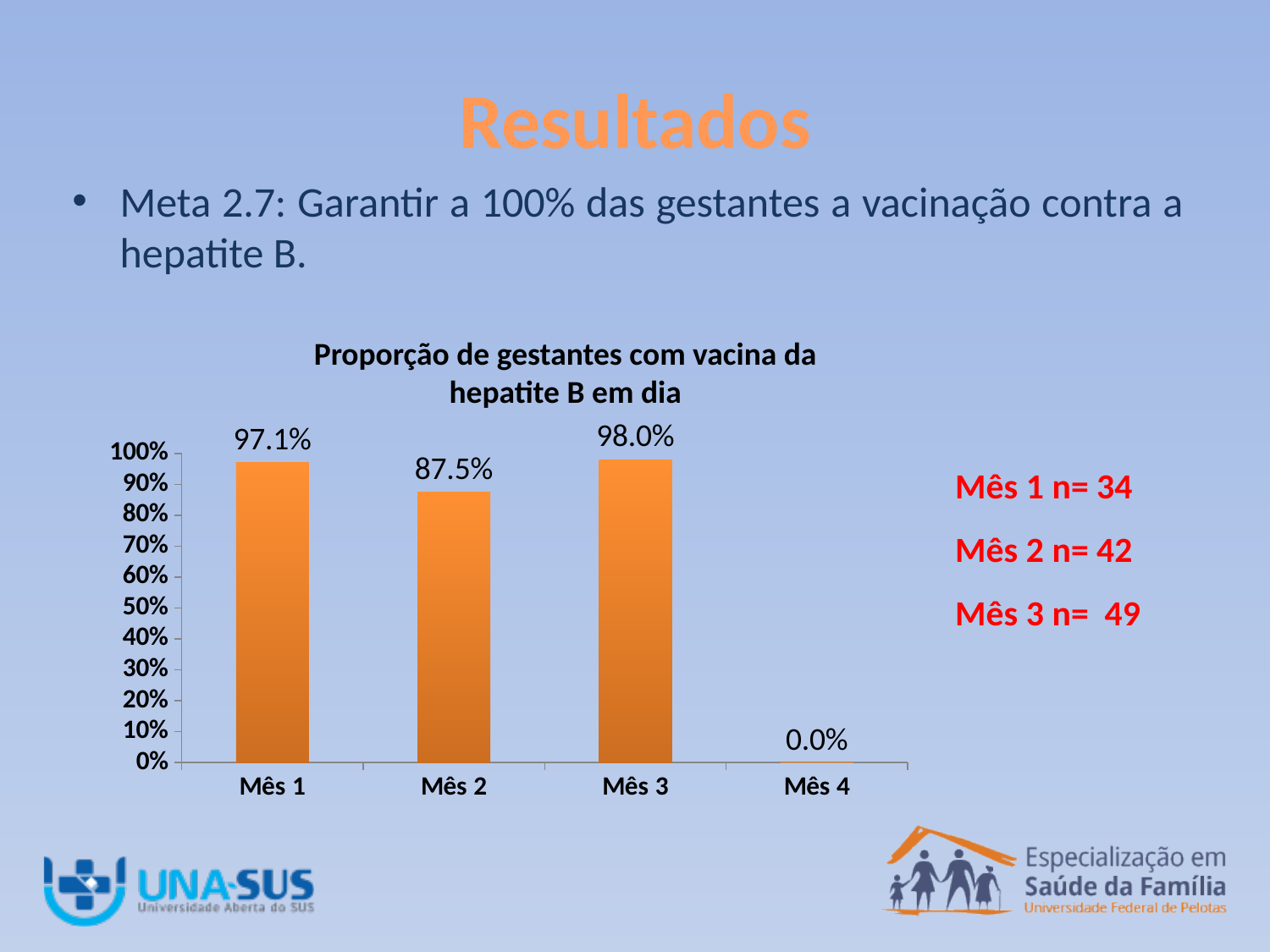
What kind of chart is shown on the slide? bar chart What is the title of the chart? Proporção de gestantes com vacina da hepatite B em dia What is the value for Mês 1? 97.1% What is the value for Mês 3? 98.0% How many months are shown on the x axis? 4 What is the difference between the values for Mês 1 and Mês 2? 9.6% What is the value for Mês 4? 0.0% Which is larger, the value for Mês 2 or the value for Mês 3? Mês 3 Which month has the highest value? Mês 3 Which month has the lowest value? Mês 4 Is the value for Mês 2 greater or less than 90%? less What is the value for Mês 2? 87.5%